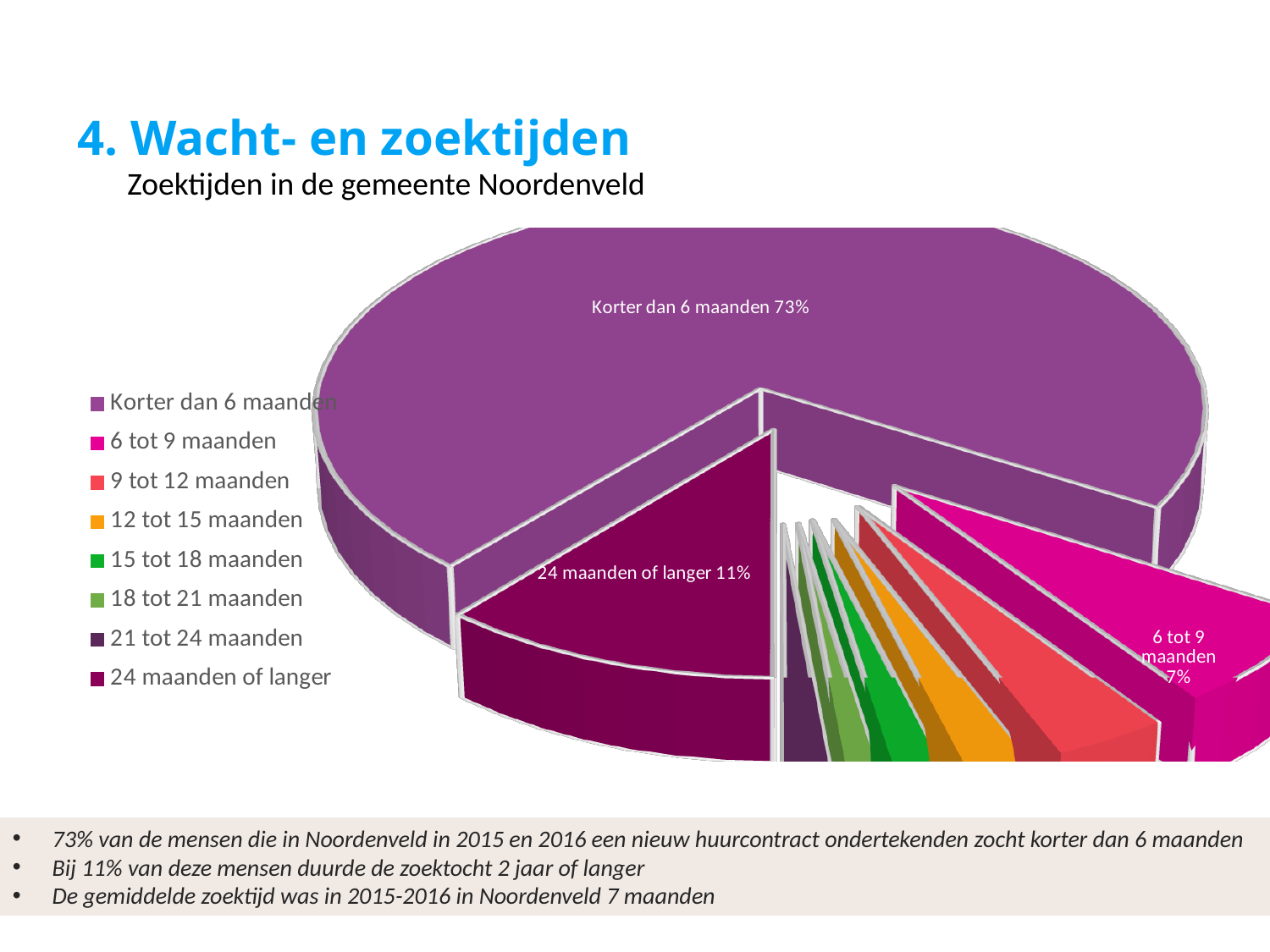
How many categories does the legend list? 8 Which category is listed first in the legend? Korter dan 6 maanden Is the share for 'Korter dan 6 maanden' greater or less than 50%? greater What percentage is shown for '24 maanden of langer'? 11% What percentage is shown for '6 tot 9 maanden'? 7% What is the difference in percentage points between 'Korter dan 6 maanden' and '24 maanden of langer'? 62 percentage points Which slice is larger: '24 maanden of langer' or '6 tot 9 maanden'? 24 maanden of langer What share of the pie does 'Korter dan 6 maanden' represent? 73% What is the subtitle of the chart on the slide? Zoektijden in de gemeente Noordenveld What is the difference in percentage points between '24 maanden of langer' and '6 tot 9 maanden'? 4 percentage points What kind of chart is shown on the slide? Pie chart Which category has the largest slice of the pie? Korter dan 6 maanden